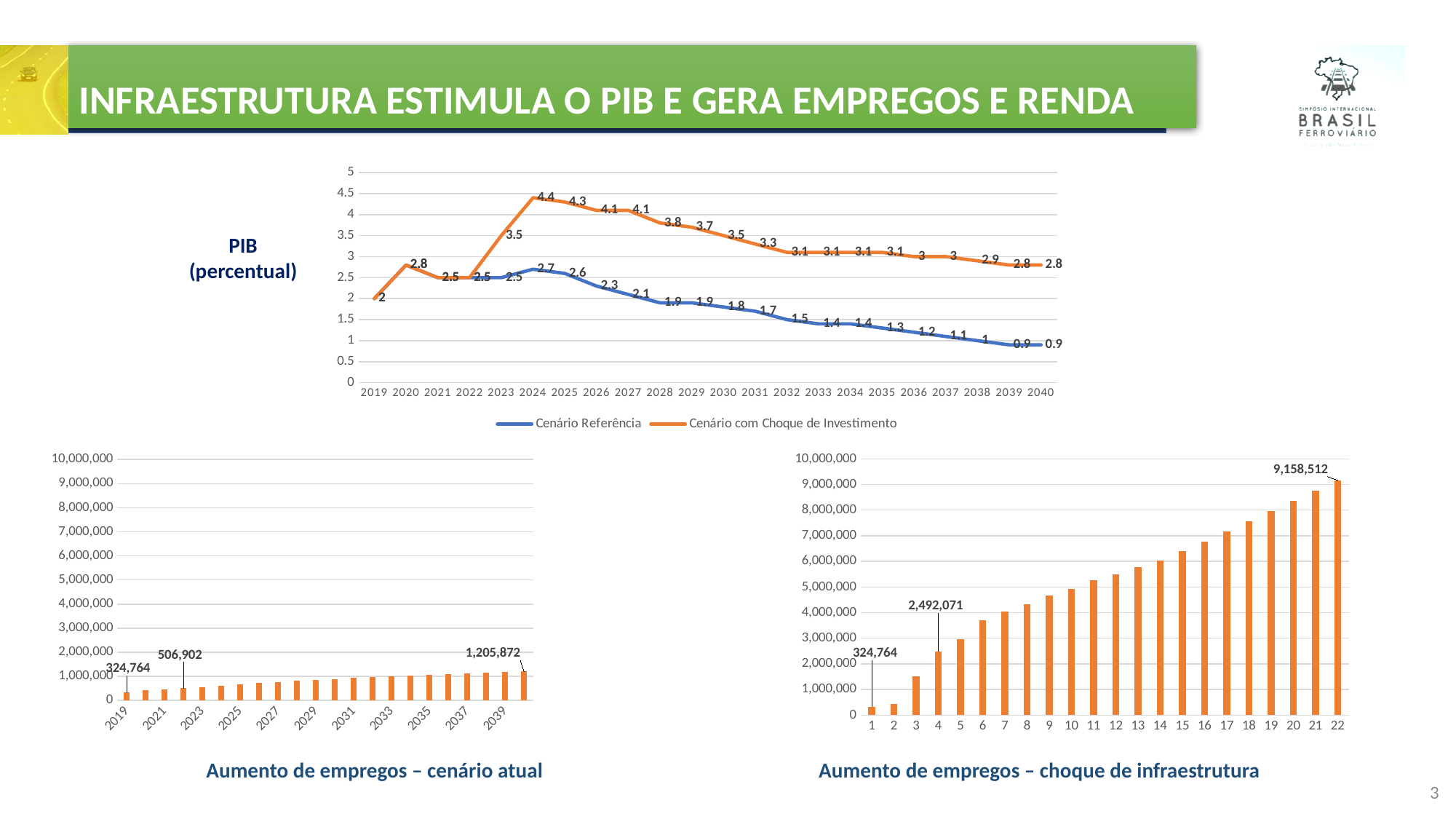
In the PIB (percentual) chart, what is the value for Cenário com Choque de Investimento in 2024? 4.4 How many series does the legend of the PIB (percentual) chart list? 2 What kind of chart is the PIB (percentual) chart? Line chart In the 'Aumento de empregos – choque de infraestrutura' chart, what is the value for category 22? 9,158,512 In the PIB (percentual) chart, which scenario has the higher value in 2030? Cenário com Choque de Investimento In the 'Aumento de empregos – cenário atual' chart, what is the highest labelled value? 1,205,872 In the 'Aumento de empregos – choque de infraestrutura' chart, is the value for category 15 greater or less than 6,000,000? greater In the PIB (percentual) chart, what is the value for Cenário Referência in 2040? 0.9 In the PIB (percentual) chart, does the Cenário Referência line rise or fall from 2024 to 2040? Fall In the PIB (percentual) chart, what is the difference between the two scenarios in 2040? 1.9 In the PIB (percentual) chart, in which year does Cenário com Choque de Investimento reach its highest value? 2024